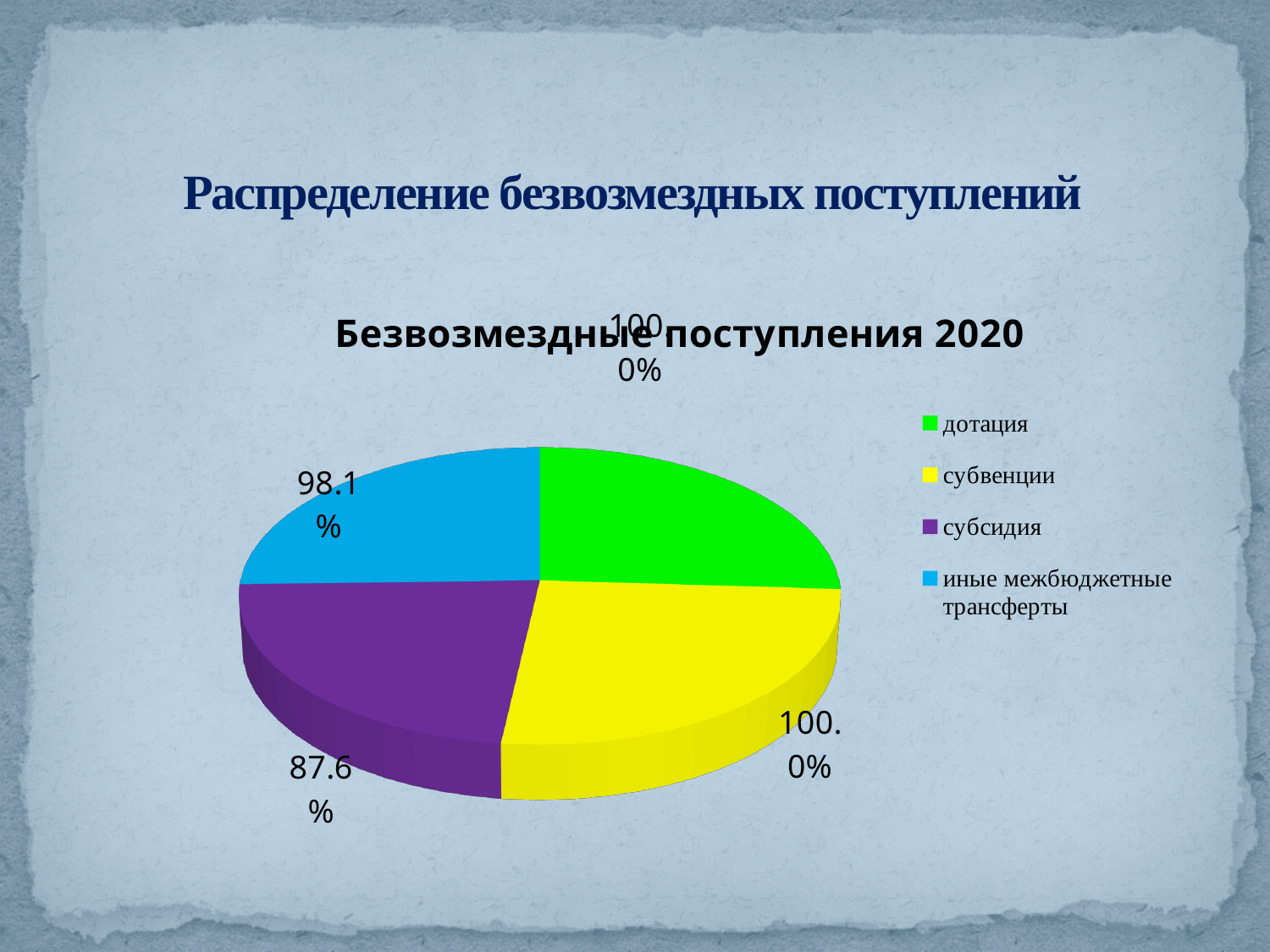
What is the title of the chart? Безвозмездные поступления 2020 How many categories does the pie chart have? 4 What value is labelled on the субсидия slice? 87.6% What colour is the субсидия slice? purple What is the difference between the labelled values for иные межбюджетные трансферты and субсидия? 10.5% What type of chart is shown on the slide? pie chart Which category has the lowest labelled value? субсидия What value is labelled on the субвенции slice? 100.0% What value is labelled on the иные межбюджетные трансферты slice? 98.1% Which has the larger labelled value, субвенции or субсидия? субвенции How many entries does the legend list? 4 Which has the larger labelled value, иные межбюджетные трансферты or субсидия? иные межбюджетные трансферты